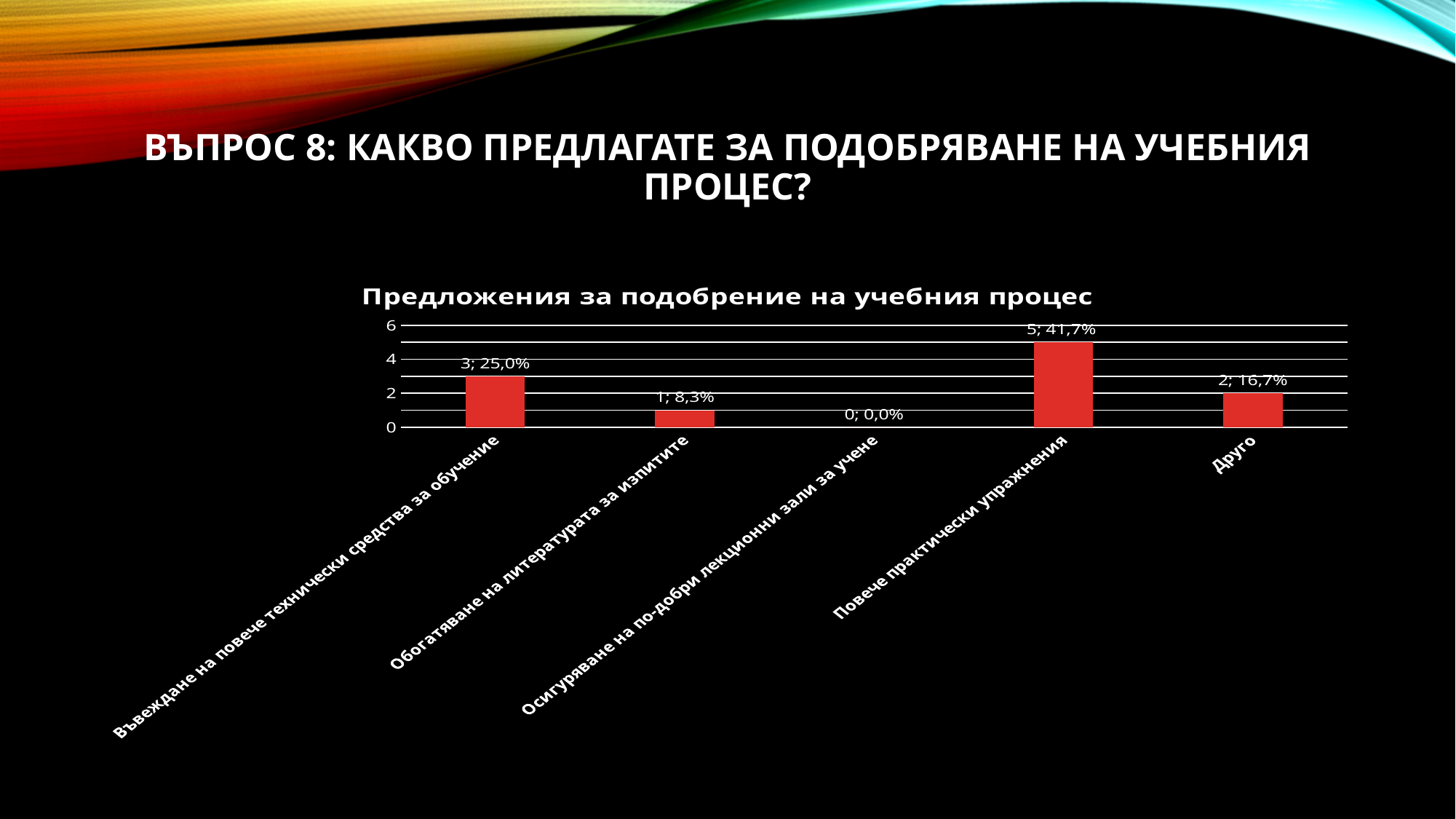
Which category has the highest value? Повече практически упражнения What is the value for "Друго"? 2; 16,7% What kind of chart is shown? bar chart What is the value for "Въвеждане на повече технически средства за обучение"? 3; 25,0% Is the value for "Повече практически упражнения" greater or less than 4? greater How many categories are shown on the x axis? 5 What is the value for "Обогатяване на литературата за изпитите"? 1; 8,3% What is the value for "Повече практически упражнения"? 5; 41,7% What is the title of the chart? Предложения за подобрение на учебния процес What is the difference in count between "Повече практически упражнения" and "Друго"? 3 Which category has the lowest value? Осигуряване на по-добри лекционни зали за учене Which is larger: the value for "Въвеждане на повече технически средства за обучение" or for "Друго"? Въвеждане на повече технически средства за обучение